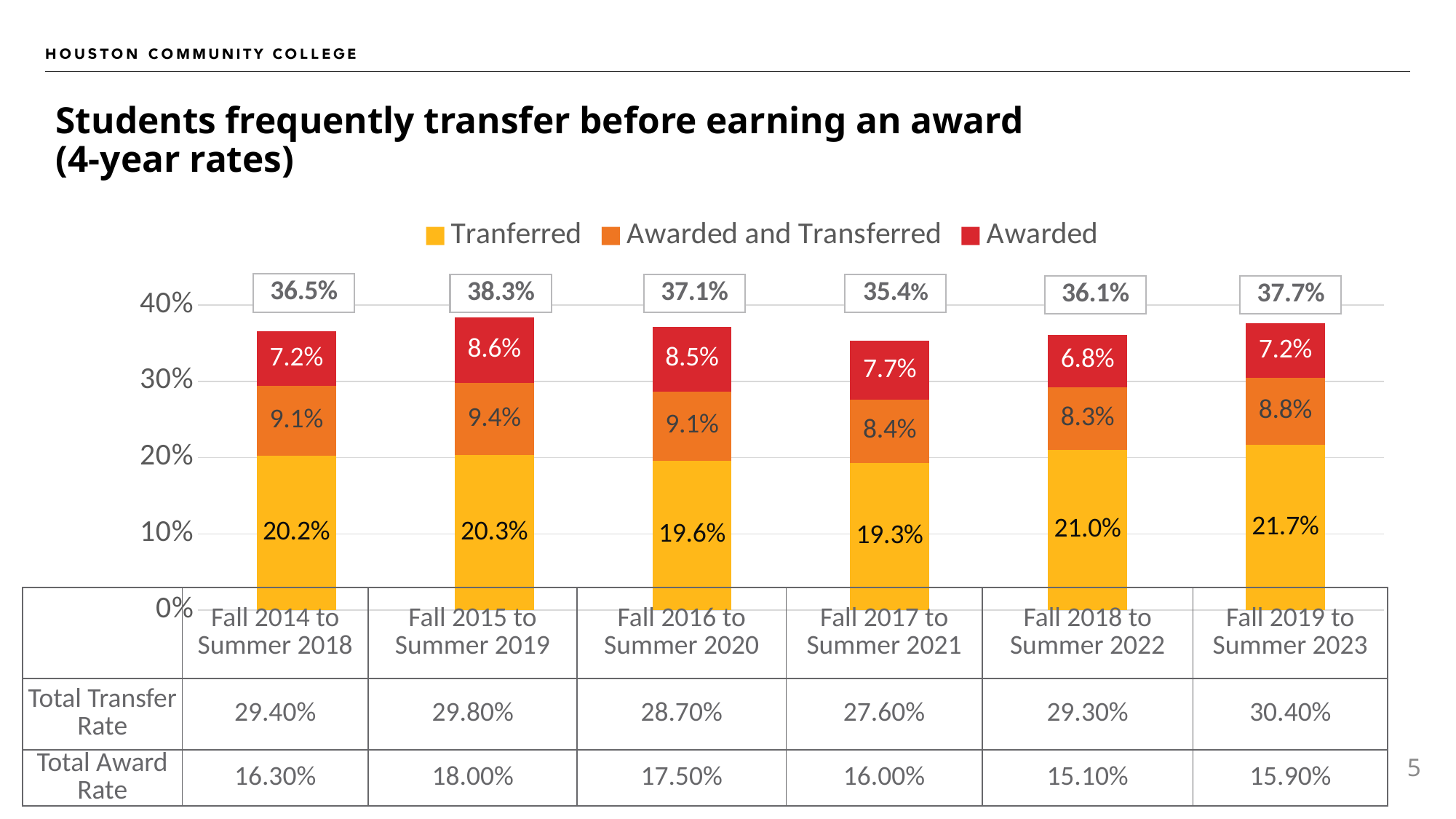
How many series does the legend list? 3 What is the Awarded and Transferred value for Fall 2019 to Summer 2023? 8.8% Which cohort has the lowest Tranferred value? Fall 2017 to Summer 2021 How many cohorts are shown on the x axis of the chart? 6 What is the total of the stacked bar for Fall 2015 to Summer 2019? 38.3% What kind of chart is shown on the slide? Stacked bar chart What is the Awarded value for Fall 2018 to Summer 2022? 6.8% Which is larger, the Awarded value for Fall 2017 to Summer 2021 or for Fall 2018 to Summer 2022? Fall 2017 to Summer 2021 What is the Tranferred value for Fall 2016 to Summer 2020? 19.6% What is the Total Transfer Rate for Fall 2019 to Summer 2023 in the table below the chart? 30.40% Which cohort has the highest stacked bar total? Fall 2015 to Summer 2019 What is the difference between the Tranferred values for Fall 2019 to Summer 2023 and Fall 2014 to Summer 2018? 1.5 percentage points